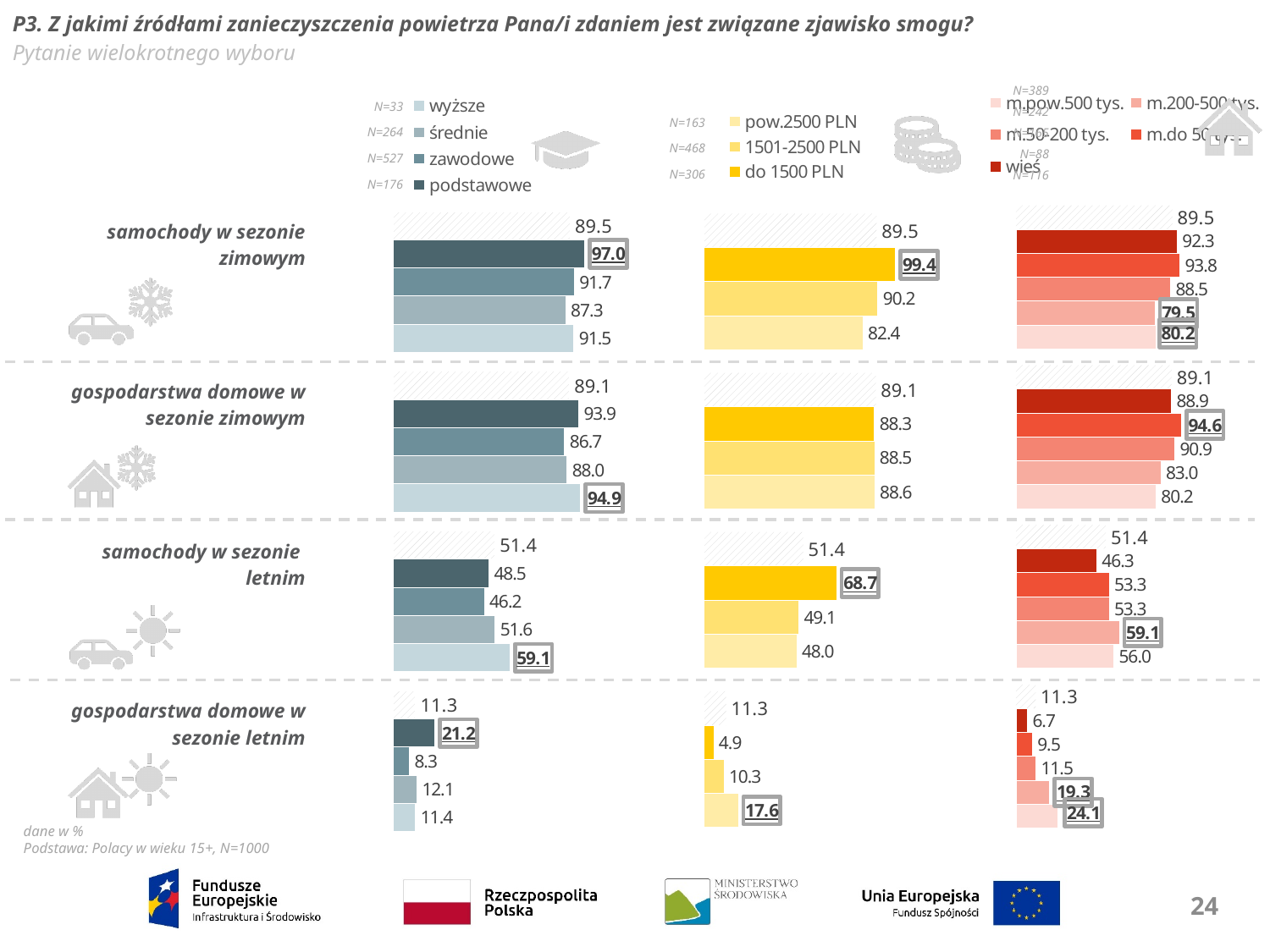
In the 'samochody w sezonie zimowym' chart broken down by education, what is the value for podstawowe? 97.0 In the 'samochody w sezonie zimowym' chart broken down by education, what is the difference between the values for podstawowe and wyższe? 5.5 In the 'gospodarstwa domowe w sezonie letnim' chart broken down by place of residence, what is the value for wieś? 6.7 In the 'gospodarstwa domowe w sezonie letnim' chart broken down by income, which income group has the lowest value? do 1500 PLN In the 'samochody w sezonie zimowym' chart broken down by income, what is the value for do 1500 PLN? 99.4 What kind of chart is used to show the results on this slide? bar chart In the 'gospodarstwa domowe w sezonie letnim' chart broken down by education, what is the value for podstawowe? 21.2 What is the overall (hatched bar) value shown for 'samochody w sezonie letnim'? 51.4 How many education groups does the education legend list? 4 In the 'gospodarstwa domowe w sezonie zimowym' chart broken down by education, which education group has the highest value? wyższe In the 'samochody w sezonie letnim' chart broken down by income, what is the difference between the values for do 1500 PLN and pow.2500 PLN? 20.7 In the 'samochody w sezonie letnim' chart broken down by income, which is larger: the value for do 1500 PLN or the value for 1501-2500 PLN? do 1500 PLN